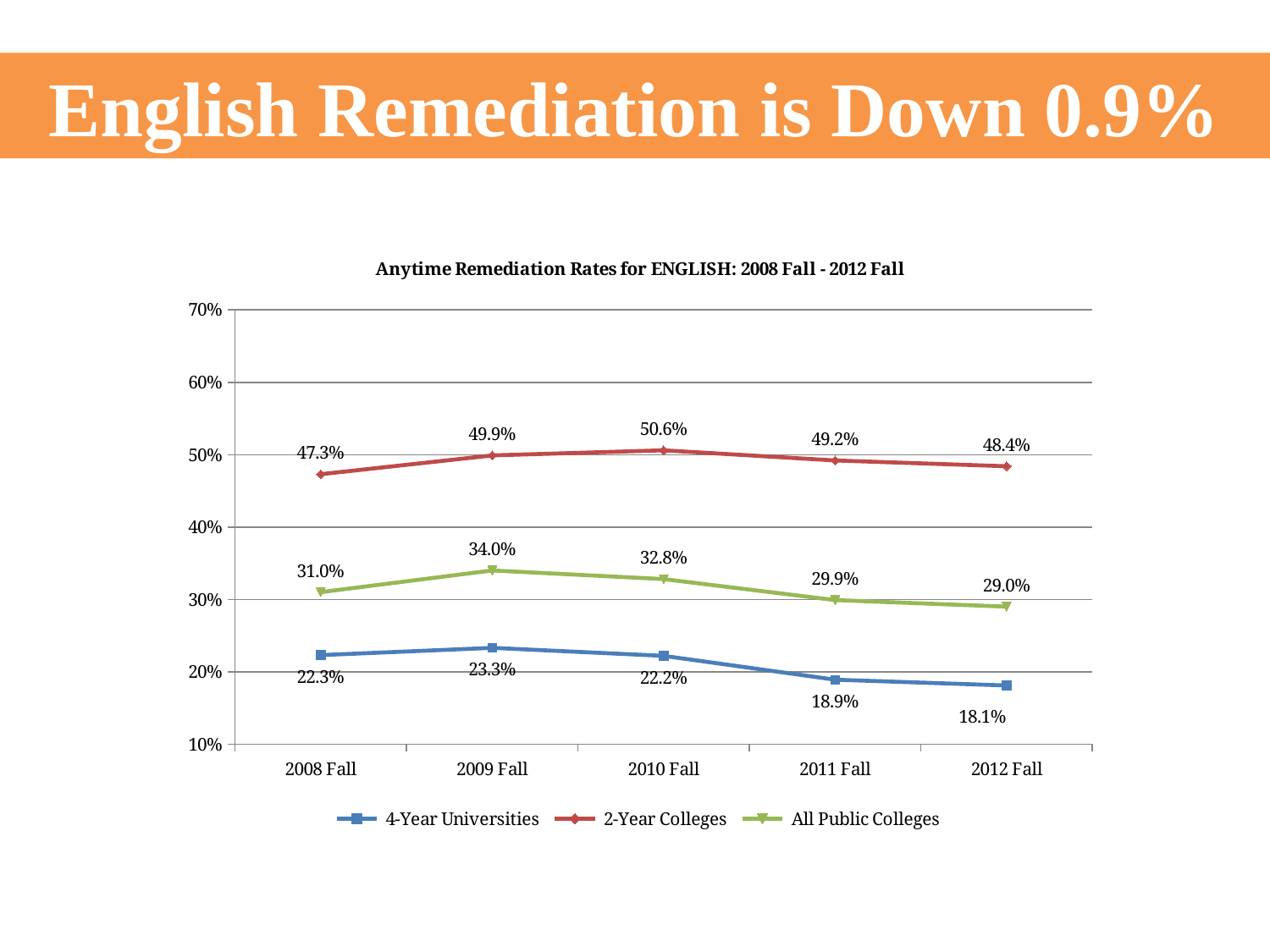
What is the difference between the All Public Colleges rate in 2008 Fall and in 2012 Fall? 2.0% What is the remediation rate for All Public Colleges in 2009 Fall? 34.0% Does the 4-Year Universities rate rise or fall from 2010 Fall to 2012 Fall? fall How many series does the legend list? 3 What kind of chart is shown on the slide? line chart How many time points are plotted on the x axis? 5 In which year is the 2-Year Colleges remediation rate highest? 2010 Fall What is the remediation rate for 2-Year Colleges in 2010 Fall? 50.6% Which is larger in 2011 Fall: the rate for 2-Year Colleges or for All Public Colleges? 2-Year Colleges Is the 2-Year Colleges rate in 2008 Fall greater or less than 50%? less What is the remediation rate for 4-Year Universities in 2012 Fall? 18.1% In which year is the 4-Year Universities remediation rate lowest? 2012 Fall